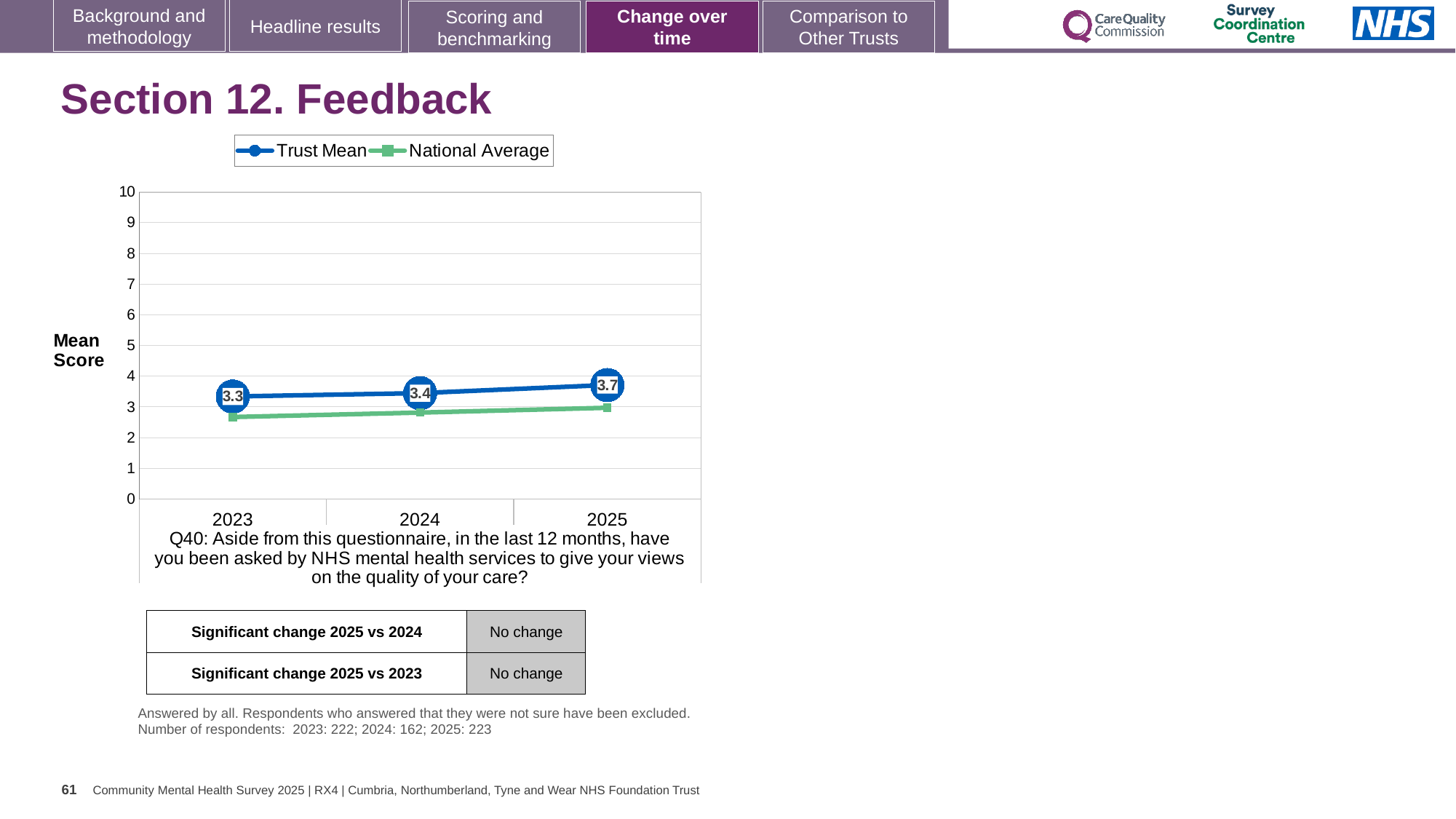
What is the Trust Mean score for 2023? 3.3 What is the difference between the Trust Mean in 2025 and in 2023? 0.4 How many years are plotted on the x axis? 3 What kind of chart is shown on the slide? line chart What is the Trust Mean score for 2025? 3.7 In which year is the Trust Mean lowest? 2023 What is the Trust Mean score for 2024? 3.4 How many series does the legend list? 2 Does the Trust Mean rise or fall from 2023 to 2025? rise Which is larger, the Trust Mean in 2025 or the Trust Mean in 2024? Trust Mean in 2025 In which year is the Trust Mean highest? 2025 Is the National Average for 2023 greater or less than 3? less